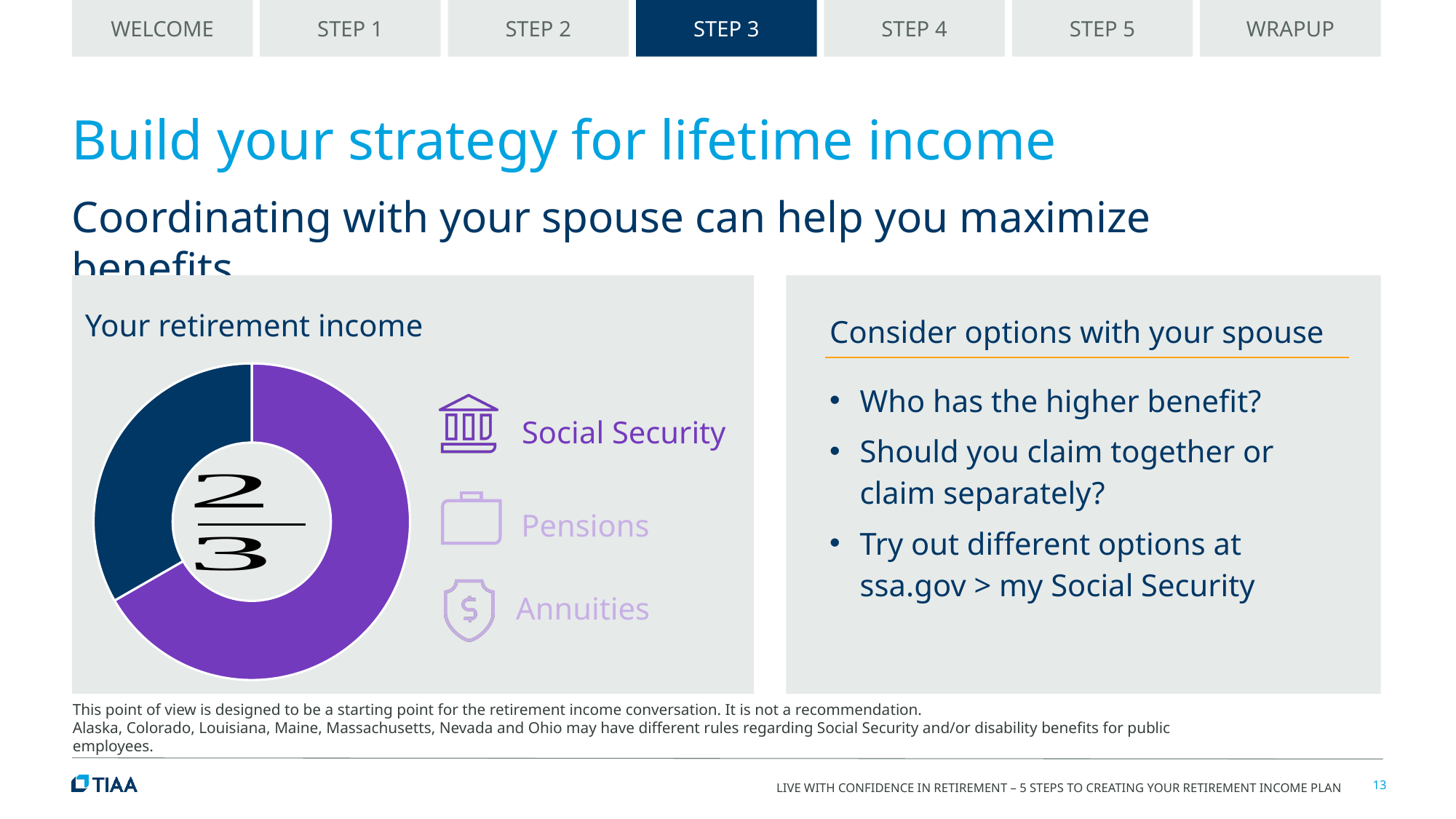
Is the Social Security share of retirement income greater or less than 50%? greater Is the Social Security slice larger or smaller than the dark navy slice? Larger How many slices does the "Your retirement income" chart have? 2 What kind of chart is shown under "Your retirement income"? Pie (donut) chart What is the title of the chart on the left side of the slide? Your retirement income What share of retirement income does the chart attribute to Social Security? 2/3 What colour is the Social Security slice in the chart? Purple Which slice of the "Your retirement income" chart is the largest? Social Security